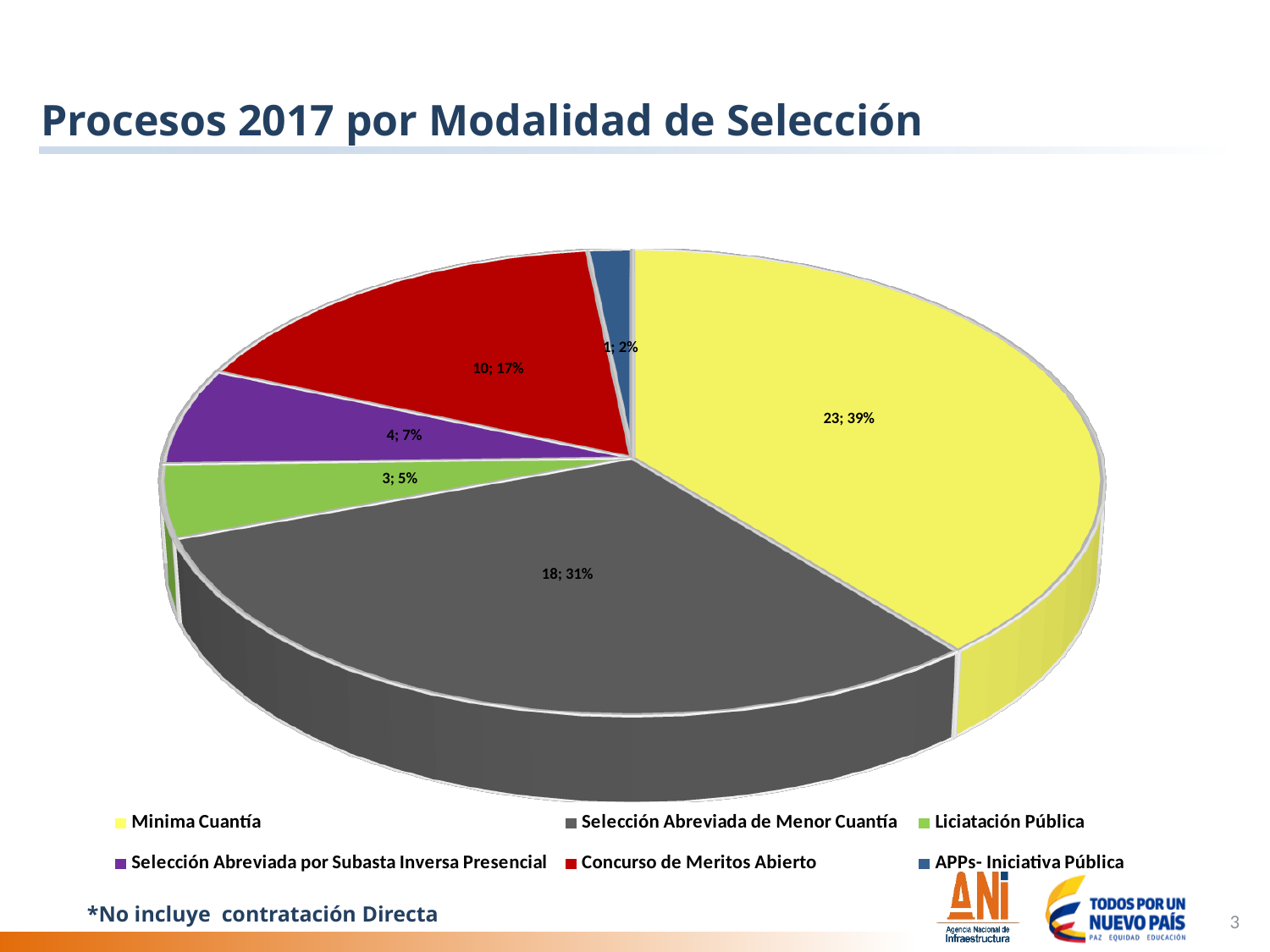
Which category has the smallest slice? APPs- Iniciativa Pública What is the title of the chart? Procesos 2017 por Modalidad de Selección What percentage share does Selección Abreviada de Menor Cuantía have? 31% What type of chart is shown on the slide? Pie chart How many processes are shown for Minima Cuantía? 23 Which category has the largest slice? Minima Cuantía Which has more processes, Selección Abreviada por Subasta Inversa Presencial or Liciatación Pública? Selección Abreviada por Subasta Inversa Presencial What colour is the slice for Concurso de Meritos Abierto? Red How many processes are shown for Concurso de Meritos Abierto? 10 What is the difference in number of processes between Minima Cuantía and Selección Abreviada de Menor Cuantía? 5 What percentage share does Liciatación Pública have? 5% How many categories does the legend list? 6